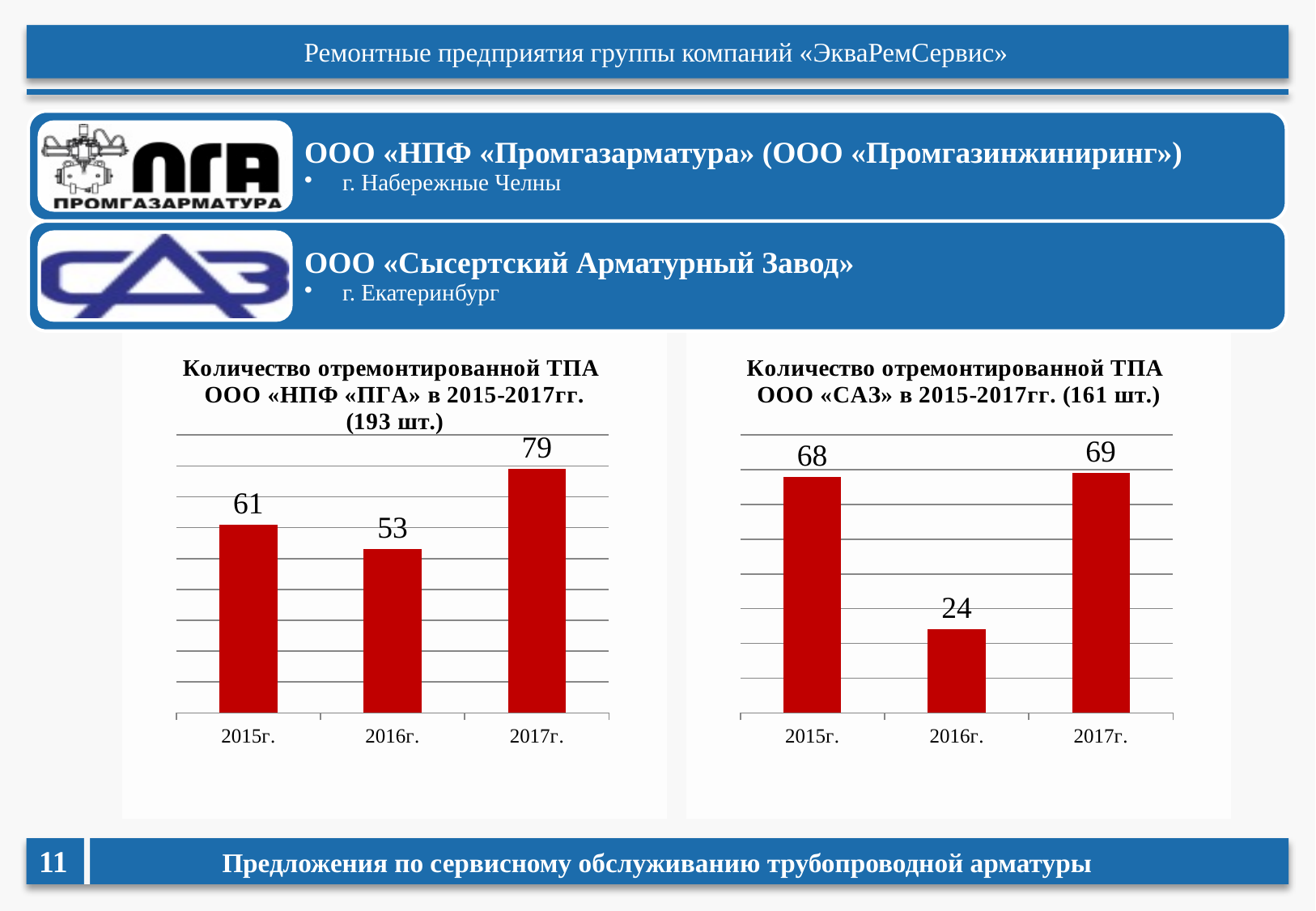
What type of chart is the left chart (ООО «НПФ «ПГА»)? bar chart In the left chart (ООО «НПФ «ПГА»), which year has the highest value? 2017г. In the right chart (ООО «САЗ»), what is the difference between the values for 2015г. and 2016г.? 44 In the left chart (ООО «НПФ «ПГА»), what is the value for 2016г.? 53 In the right chart (ООО «САЗ»), what is the value for 2016г.? 24 According to the title of the right chart, what is the total number of repaired ТПА for ООО «САЗ» in 2015-2017? 161 шт. In the left chart (ООО «НПФ «ПГА»), which is larger, the value for 2015г. or 2016г.? 2015г. In the right chart (ООО «САЗ»), what is the value for 2015г.? 68 In the left chart (ООО «НПФ «ПГА»), how many repaired ТПА are shown for 2017г.? 79 How many years are shown on the x axis of the right chart (ООО «САЗ»)? 3 In the right chart (ООО «САЗ»), which year has the lowest value? 2016г. In the left chart (ООО «НПФ «ПГА»), what is the difference between the values for 2017г. and 2016г.? 26